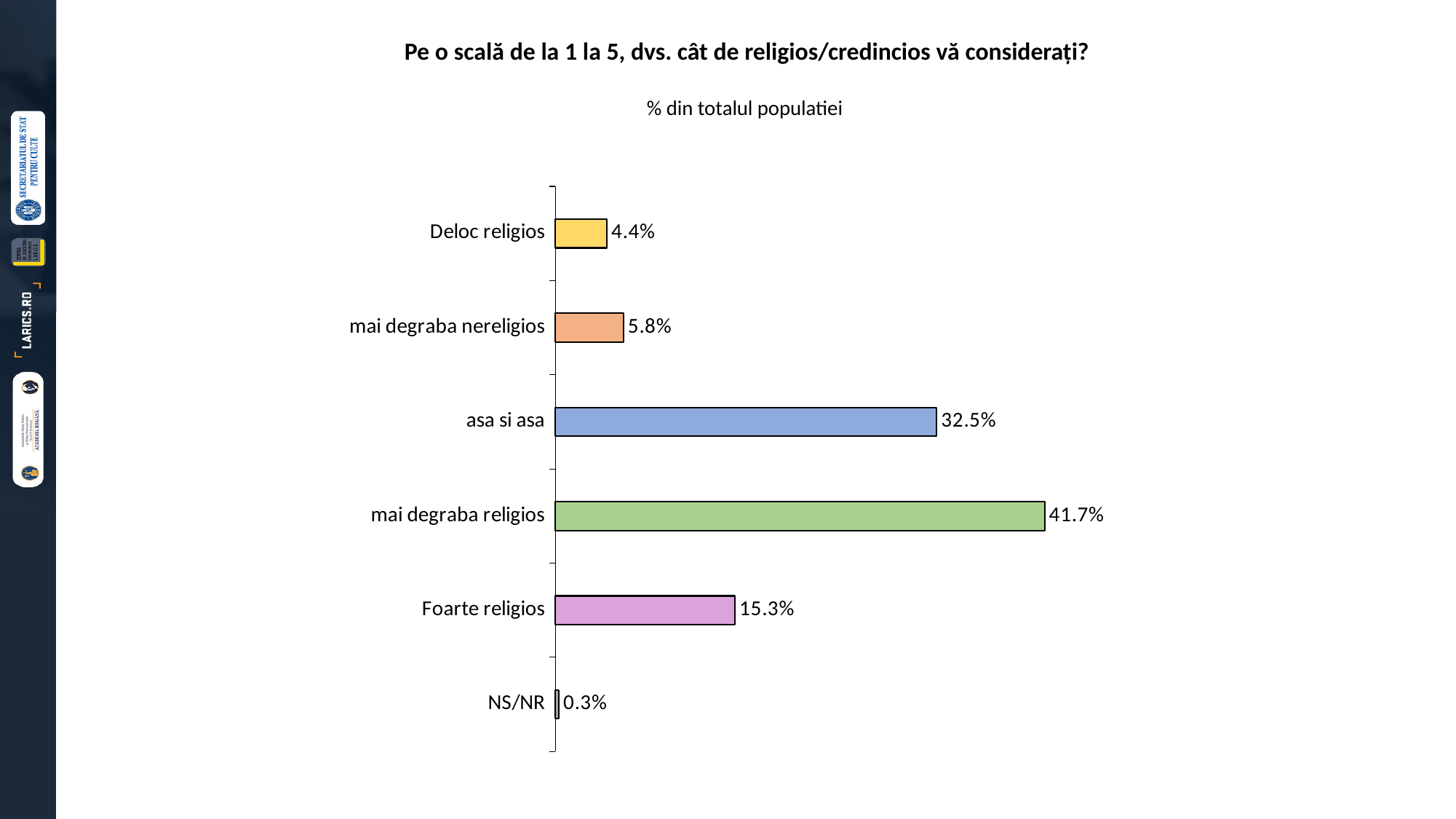
What is the value for "asa si asa"? 32.5% How many categories are shown in the chart? 6 What is the difference between "mai degraba religios" and "asa si asa"? 9.2% Which category has the highest value? mai degraba religios What kind of chart is shown on the slide? bar chart What is the value for "NS/NR"? 0.3% What is the value for "mai degraba religios"? 41.7% What is the value for "Deloc religios"? 4.4% What is the subtitle shown above the chart? % din totalul populatiei Which is larger, "Foarte religios" or "Deloc religios"? Foarte religios What is the difference between "Foarte religios" and "mai degraba nereligios"? 9.5% Which category has the lowest value? NS/NR